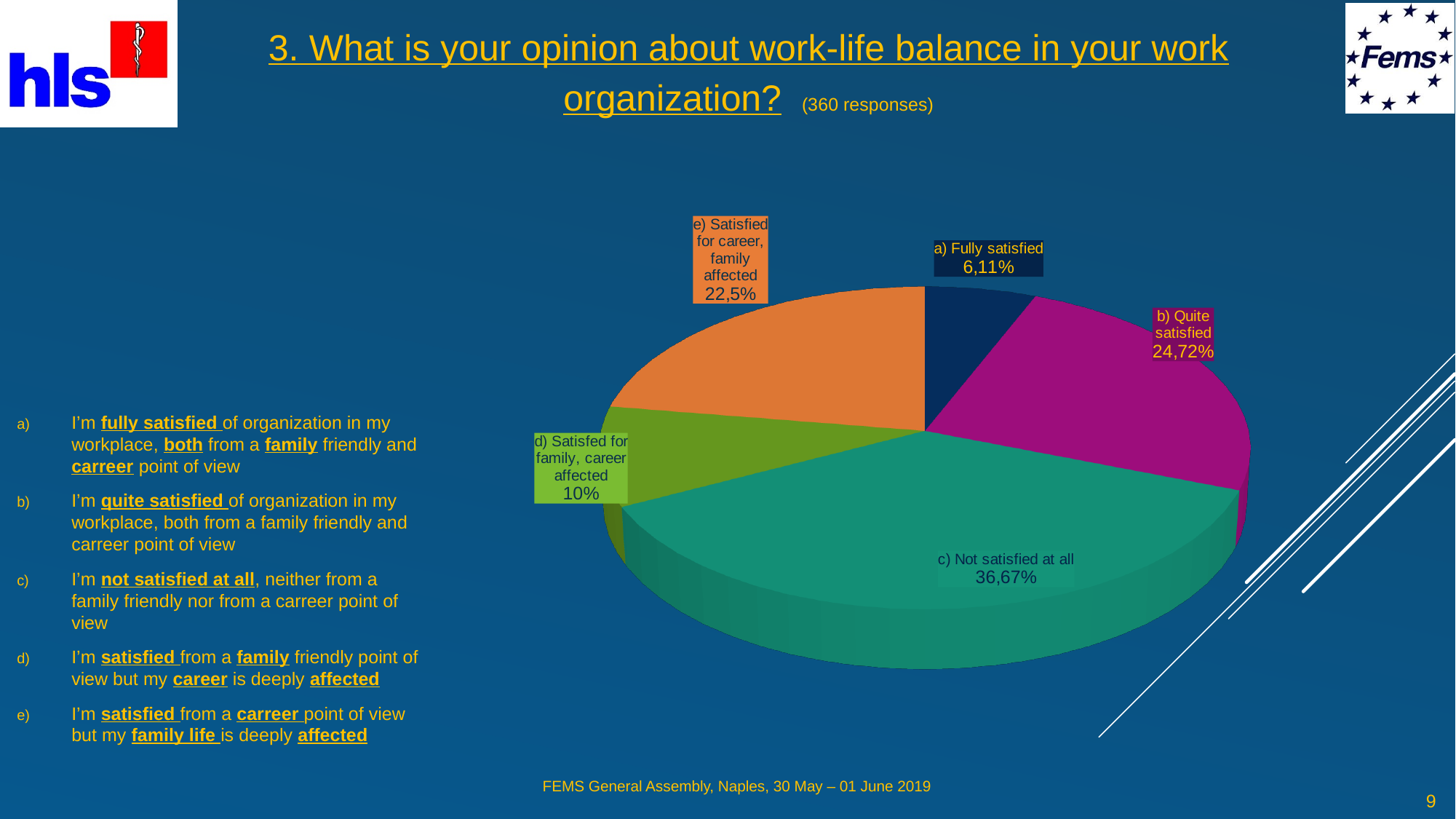
How many responses does the slide say the chart is based on? 360 responses What percentage of respondents answered "c) Not satisfied at all"? 36,67% What percentage of respondents answered "d) Satisfed for family, career affected"? 10% Which response option has the smallest share of the pie? a) Fully satisfied What percentage of respondents answered "e) Satisfied for career, family affected"? 22,5% What percentage of respondents answered "a) Fully satisfied"? 6,11% What is the difference in percentage points between "c) Not satisfied at all" and "b) Quite satisfied"? 11,95 Which response option has the largest share of the pie? c) Not satisfied at all Which has a larger share: "b) Quite satisfied" or "e) Satisfied for career, family affected"? b) Quite satisfied What percentage of respondents answered "b) Quite satisfied"? 24,72% What kind of chart is shown on the slide? pie chart How many slices does the pie chart have? 5